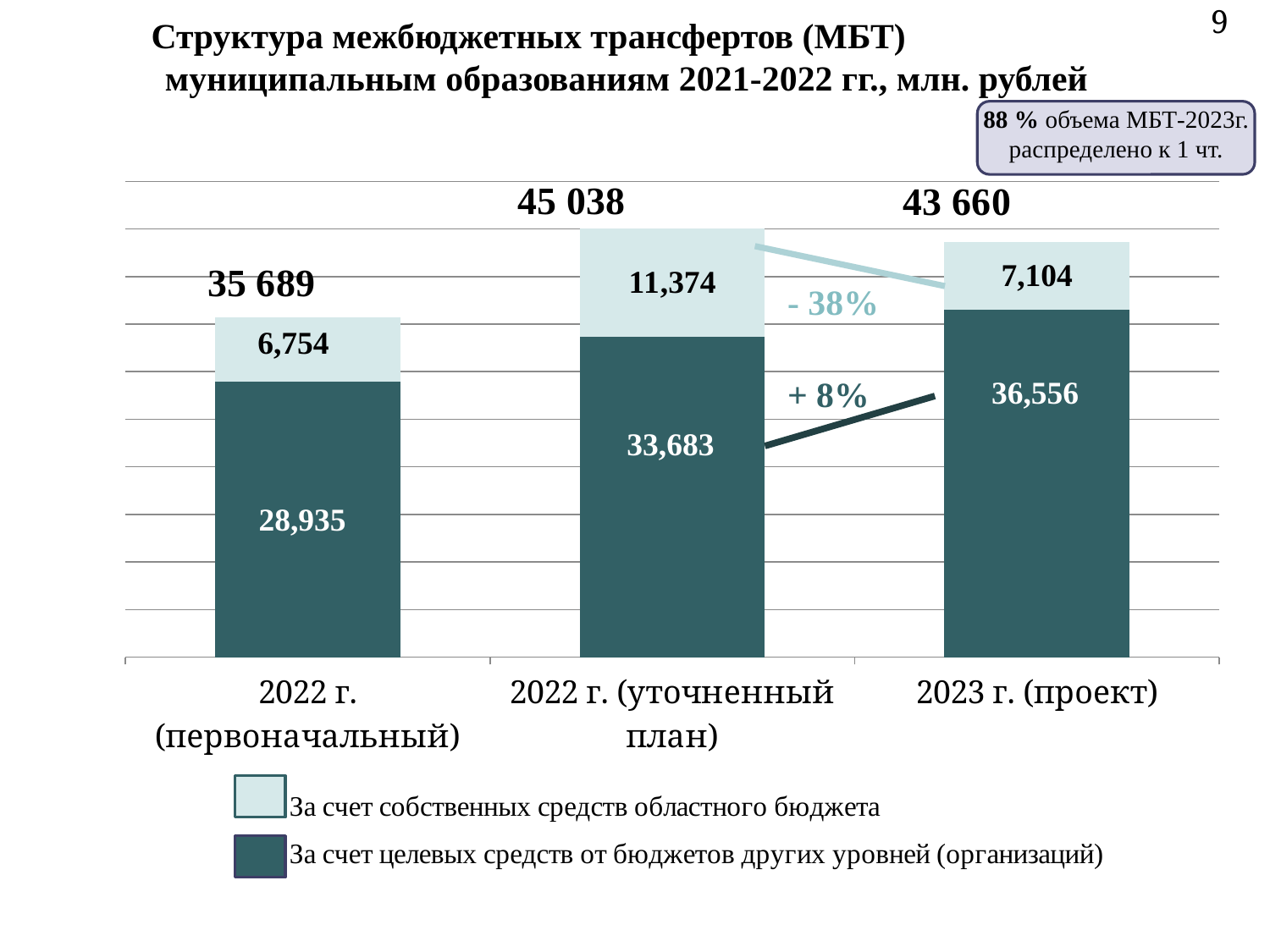
How many series does the legend list? 2 What is the total of the stacked bar for 2023 г. (проект)? 43 660 Which category has the lowest value for 'За счет собственных средств областного бюджета'? 2022 г. (первоначальный) What is the difference between the 'За счет целевых средств от бюджетов других уровней (организаций)' values for 2023 г. (проект) and 2022 г. (уточненный план)? 2,873 What is the value for 'За счет целевых средств от бюджетов других уровней (организаций)' in 2022 г. (уточненный план)? 33,683 What kind of chart is shown on the slide? Stacked bar chart What is the value for 'За счет собственных средств областного бюджета' in 2023 г. (проект)? 7,104 Which is larger: the 'За счет собственных средств областного бюджета' value for 2022 г. (уточненный план) or for 2023 г. (проект)? 2022 г. (уточненный план) How many categories are shown on the x axis of the chart? 3 Which category has the highest value for 'За счет целевых средств от бюджетов других уровней (организаций)'? 2023 г. (проект) What is the total of the stacked bar for 2022 г. (уточненный план)? 45 038 What is the value for 'За счет собственных средств областного бюджета' in 2022 г. (первоначальный)? 6,754